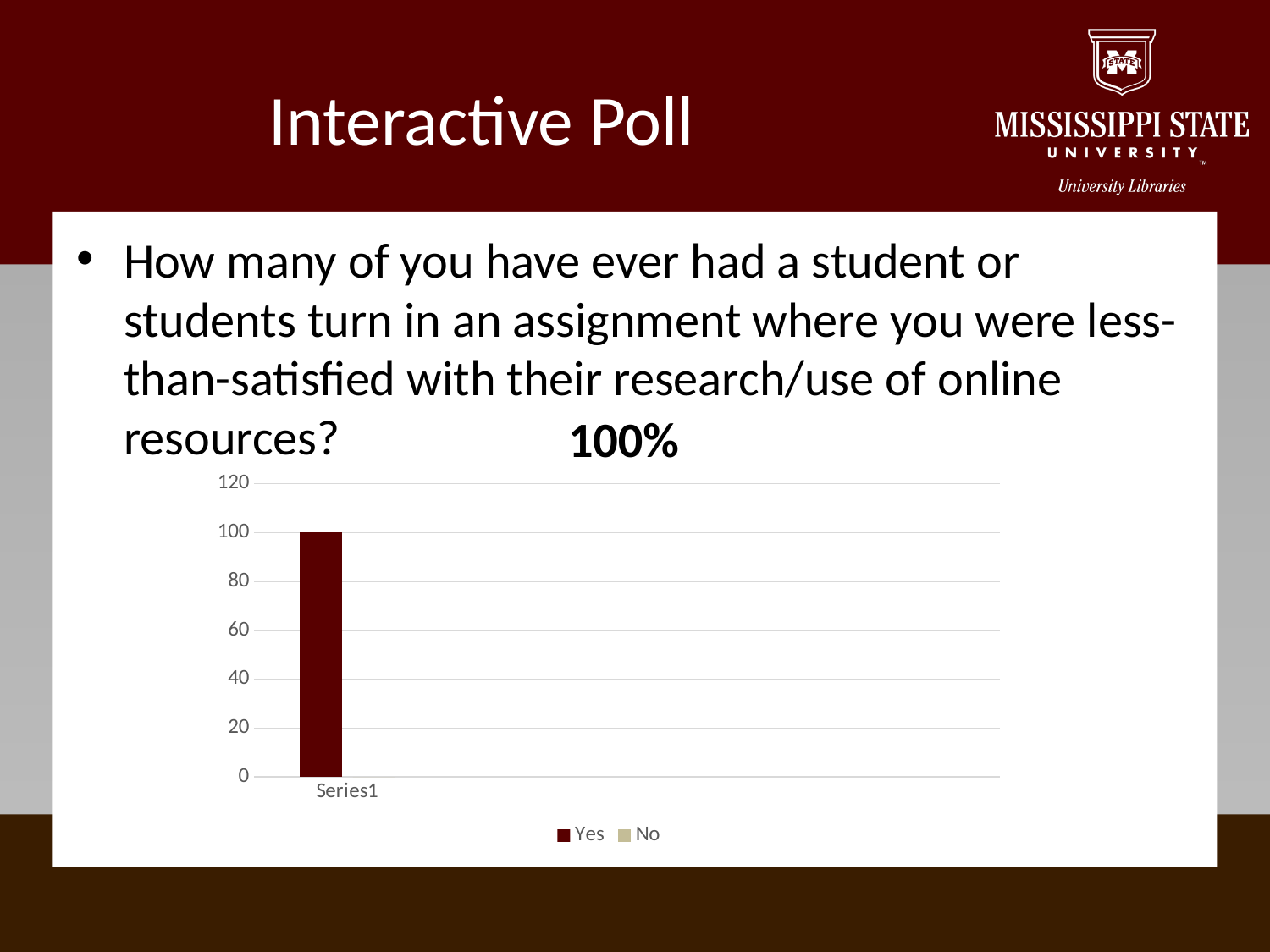
How many series does the chart legend list? 2 What kind of chart is shown on the slide? bar chart What is the highest tick value shown on the vertical axis? 120 Which series has the highest bar in the chart? Yes What are the two entries listed in the chart legend? Yes, No How many categories are shown on the x axis of the chart? 1 What value does the Yes bar reach on the vertical axis? 100 Is the value for Yes greater or less than 120? less Is the value for Yes greater or less than 80? greater Which is larger, the value for Yes or the value for No? Yes What is the label of the category on the x axis? Series1